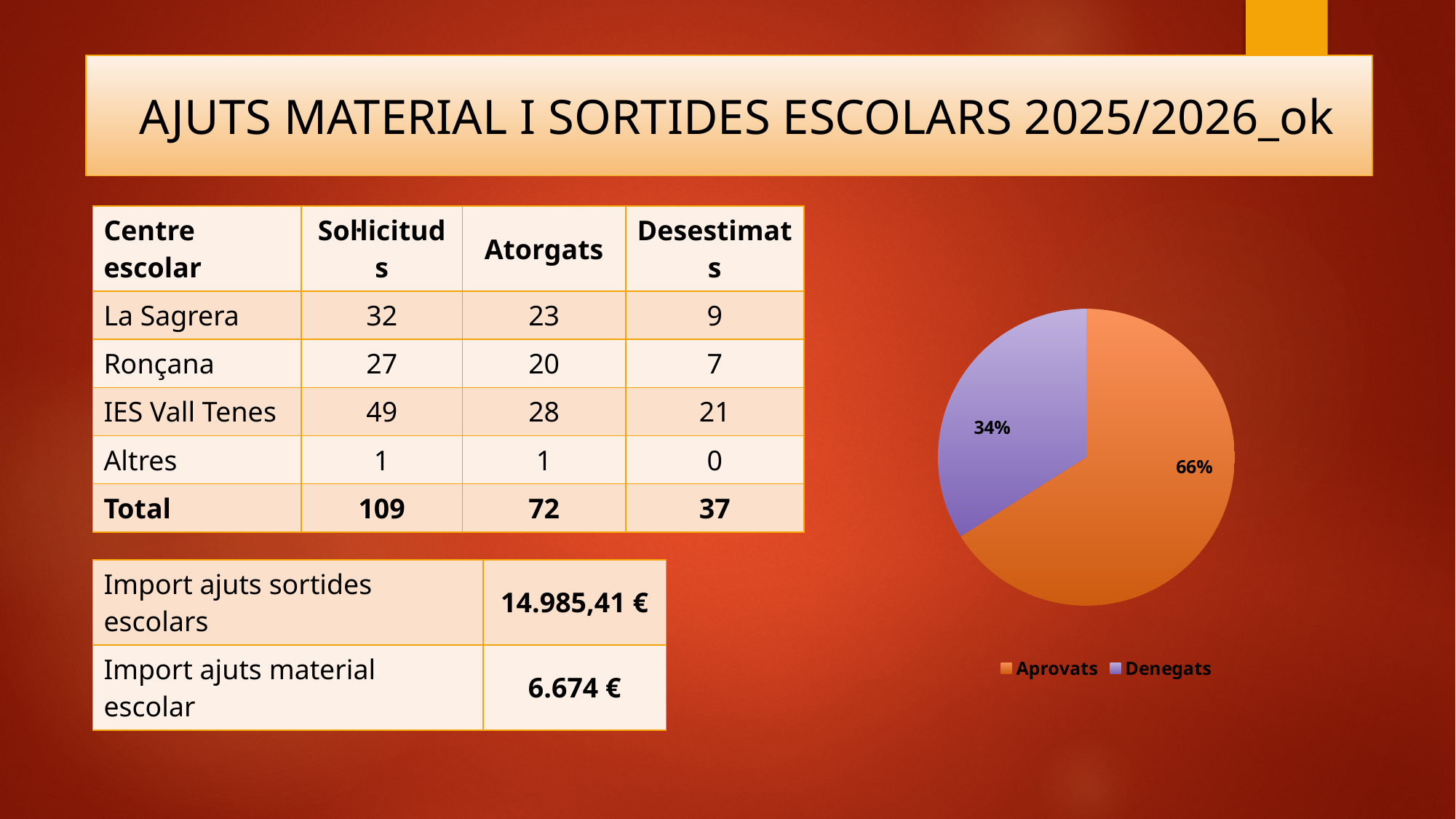
What kind of chart is shown on the slide? pie chart How many slices does the pie chart have? 2 What colour is the Aprovats slice in the pie chart? orange What share of the pie chart does Denegats represent? 34% What is the difference in percentage points between the Aprovats and Denegats slices of the pie chart? 32 Which slice of the pie chart is the smallest? Denegats In the pie chart, which is larger, Aprovats or Denegats? Aprovats What colour is the Denegats slice in the pie chart? purple What share of the pie chart does Aprovats represent? 66% How many entries does the pie chart legend list? 2 Which slice of the pie chart is the largest? Aprovats